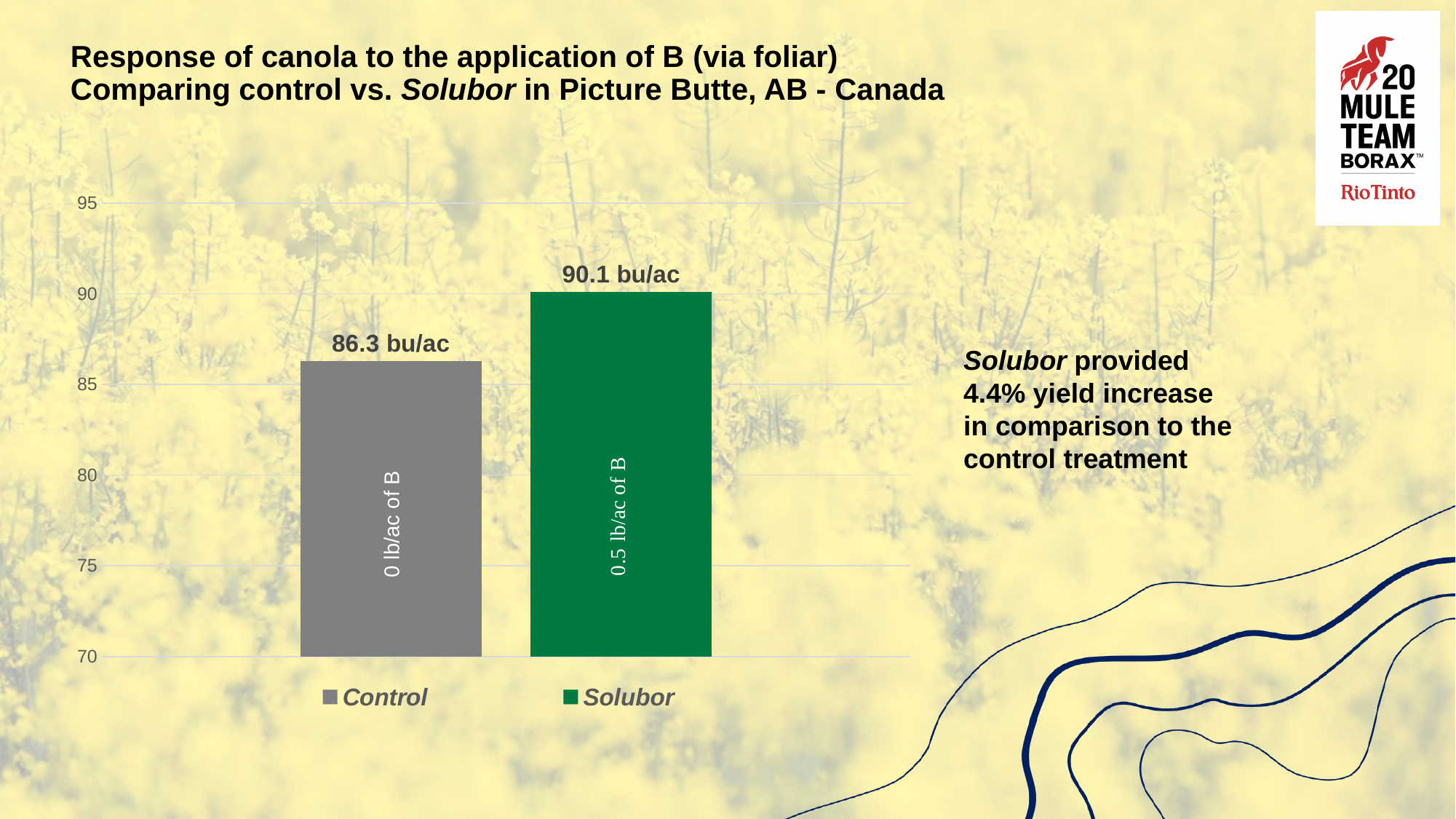
What is the yield value for the Control treatment? 86.3 bu/ac Is the yield for Solubor greater or less than 90? greater What kind of chart is shown on the slide? Bar chart Is the yield for Control greater or less than 85? greater What is the yield value for the Solubor treatment? 90.1 bu/ac How many series does the legend list? 2 How many bars are plotted in the chart? 2 Which treatment has the lower yield? Control What is the difference in yield between Solubor and Control? 3.8 bu/ac What application rate of B is labelled on the Solubor bar? 0.5 lb/ac of B Which treatment has the higher yield? Solubor What colour is the Solubor bar? Green